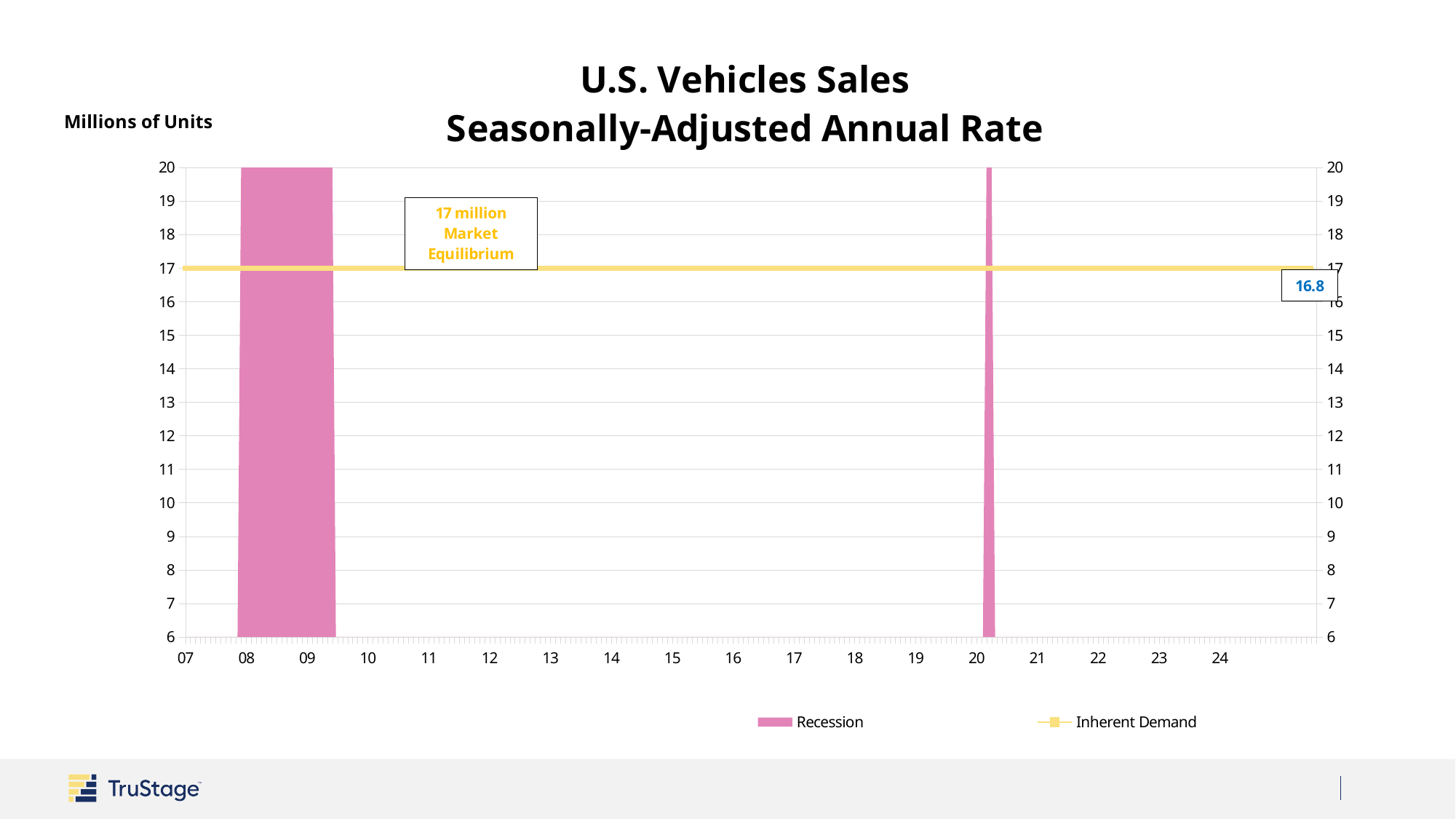
What kind of chart element is used to plot the Inherent Demand series? line Does the Inherent Demand line rise, fall, or stay flat across the years shown? stay flat Is the Inherent Demand line greater or less than 15 on the vertical axis? greater What value is printed in the data label at the right end of the chart? 16.8 What is the title of the chart? U.S. Vehicles Sales Seasonally-Adjusted Annual Rate What is the first year label on the horizontal axis? 07 What unit is shown for the vertical axis of the chart? Millions of Units How many shaded Recession periods appear on the chart? 2 How many series does the chart legend list? 2 At what level is the Inherent Demand line drawn, according to the annotation on the chart? 17 million What is the highest value shown on the vertical axis of the chart? 20 Is the Inherent Demand line greater or less than 18 on the vertical axis? less